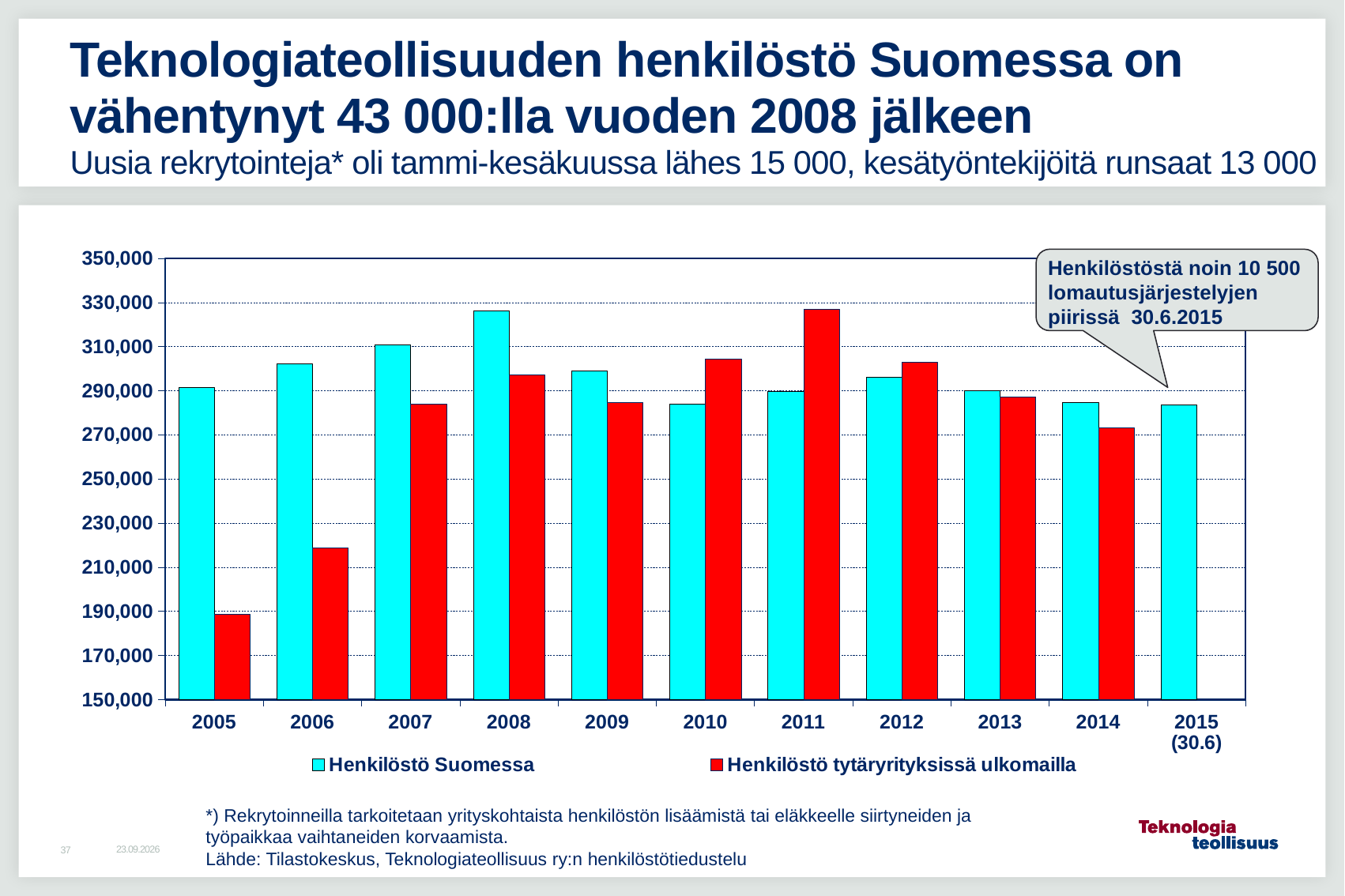
Which year has the lowest value for Henkilöstö tytäryrityksissä ulkomailla? 2005 What kind of chart is shown on the slide? bar chart In 2011, which is larger: Henkilöstö Suomessa or Henkilöstö tytäryrityksissä ulkomailla? Henkilöstö tytäryrityksissä ulkomailla Is the value for Henkilöstö tytäryrityksissä ulkomailla in 2014 greater or less than 290,000? less Which year has the highest value for Henkilöstö Suomessa? 2008 Does the value for Henkilöstö tytäryrityksissä ulkomailla rise or fall from 2005 to 2008? rise How many series does the legend list? 2 Which year has the highest value for Henkilöstö tytäryrityksissä ulkomailla? 2011 In 2005, which is larger: Henkilöstö Suomessa or Henkilöstö tytäryrityksissä ulkomailla? Henkilöstö Suomessa Is the value for Henkilöstö Suomessa in 2008 greater or less than 310,000? greater How many years (categories) are shown on the x axis? 11 Is the value for Henkilöstö tytäryrityksissä ulkomailla in 2006 greater or less than 210,000? greater